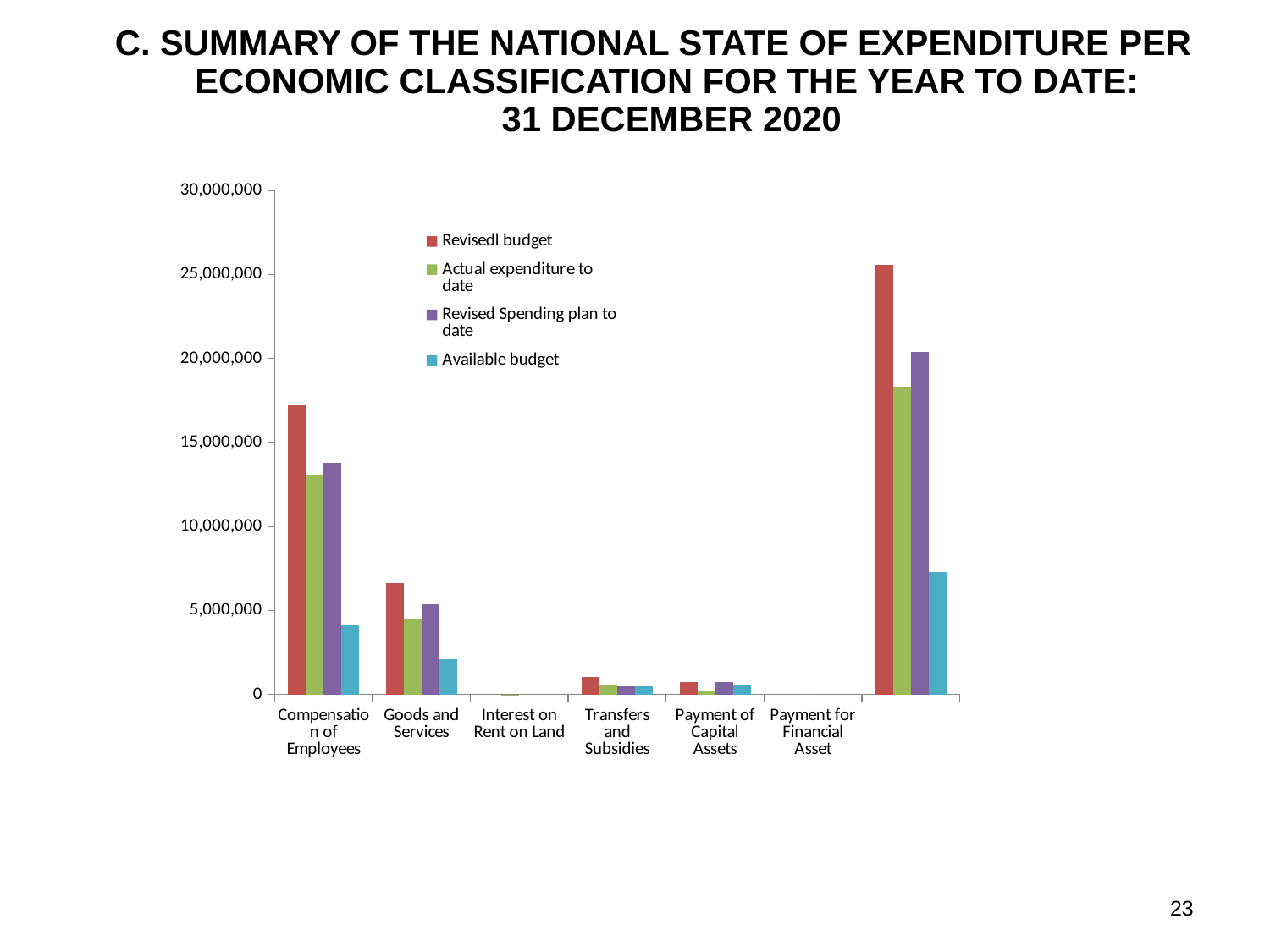
For Goods and Services, which is larger: the Revised Spending plan to date or the Available budget? Revised Spending plan to date Is the Available budget value for Compensation of Employees greater or less than 5,000,000? less Is the Revisedl budget value for Compensation of Employees greater or less than 15,000,000? greater Among the labeled categories, which has the highest Revisedl budget value? Compensation of Employees Is the Actual expenditure to date value for Goods and Services greater or less than 5,000,000? less What date does the chart title say the year-to-date figures run to? 31 December 2020 What kind of chart is shown on the slide? bar chart How many series does the legend list? 4 Which colour represents Available budget in the legend? blue For Compensation of Employees, which is larger: the Revisedl budget or the Actual expenditure to date? Revisedl budget